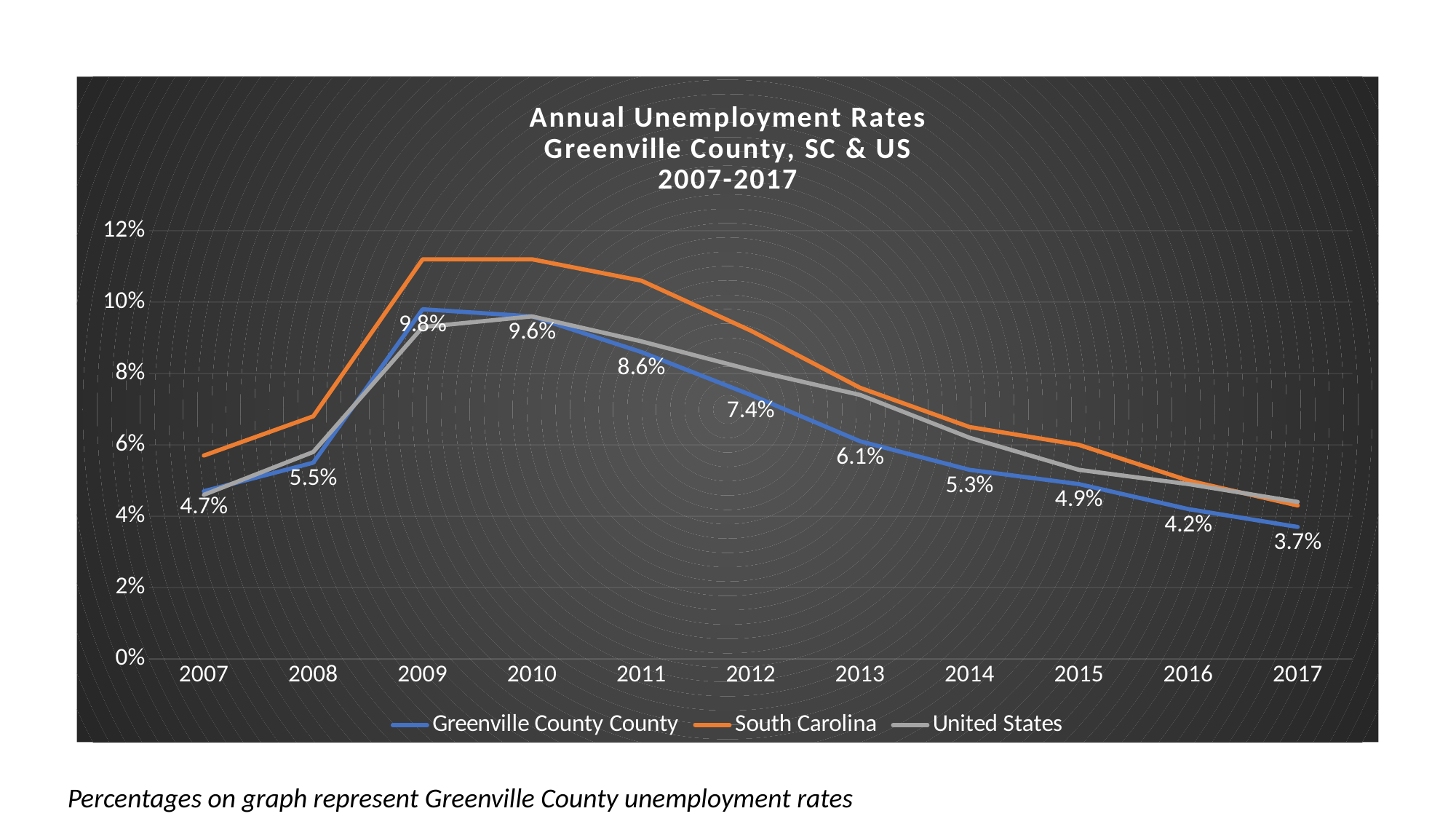
What was the Greenville County unemployment rate in 2009? 9.8% What was the Greenville County unemployment rate in 2012? 7.4% Is the South Carolina unemployment rate in 2009 greater or less than 10%? greater What kind of chart is shown on the slide? Line chart How many series does the legend list? 3 Which was higher for Greenville County, the unemployment rate in 2008 or in 2011? 2011 What was the Greenville County unemployment rate in 2017? 3.7% In which year was the Greenville County unemployment rate lowest? 2017 Did the Greenville County unemployment rate rise or fall from 2009 to 2017? Fall How many years are shown on the x axis? 11 In which year was the Greenville County unemployment rate highest? 2009 What is the difference between the Greenville County unemployment rate in 2009 and in 2017? 6.1%